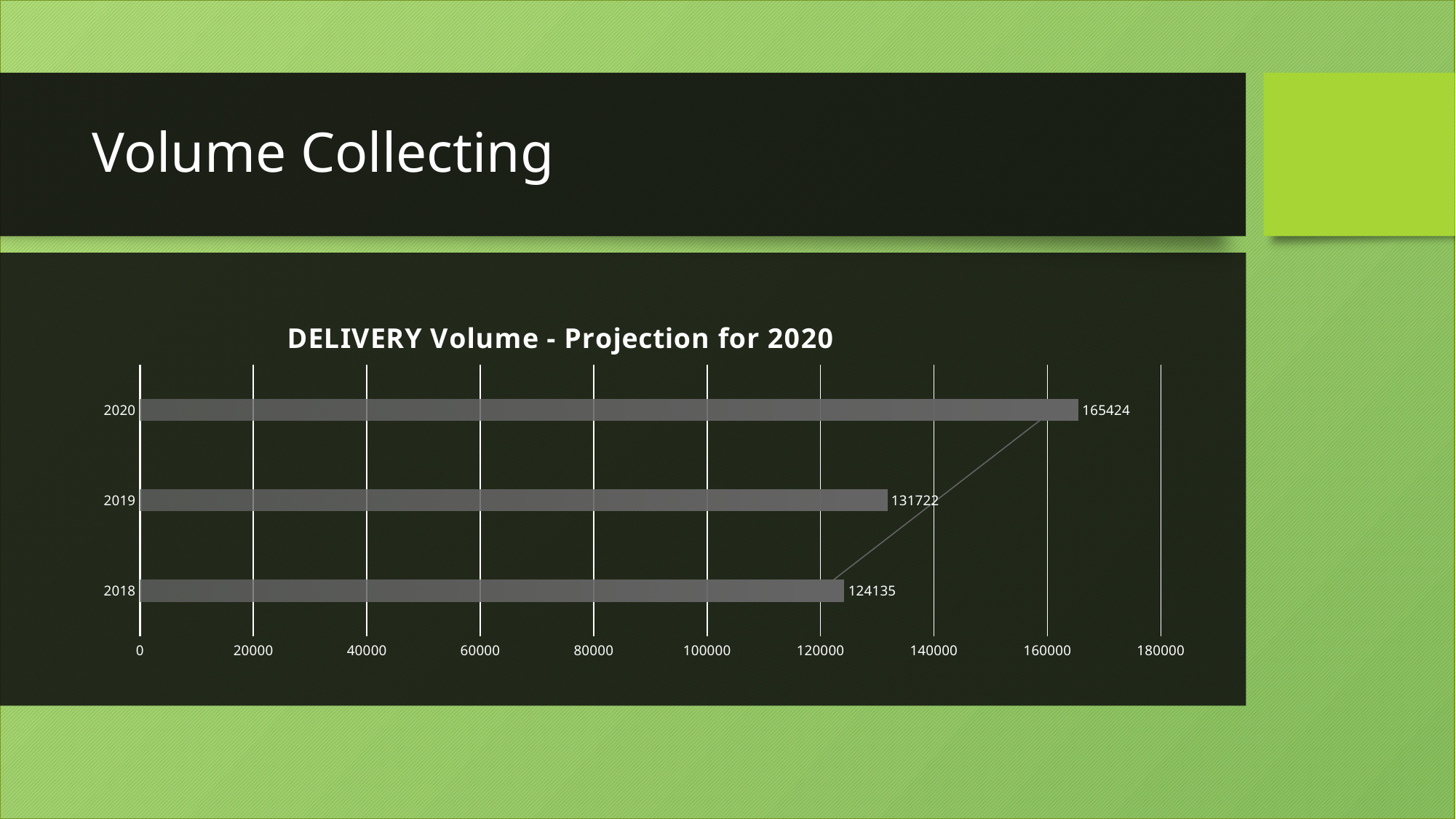
What is the difference between the 2020 and 2019 delivery volumes? 33702 What is the delivery volume value for 2018? 124135 What is the title of the chart? DELIVERY Volume - Projection for 2020 Which is larger, the delivery volume for 2019 or for 2018? 2019 Which year has the lowest delivery volume? 2018 What is the delivery volume value for 2019? 131722 What kind of chart is shown on the slide? bar chart Which year has the highest delivery volume? 2020 Is the value for 2020 greater or less than 160000? greater What is the difference between the 2019 and 2018 delivery volumes? 7587 How many years are shown in the chart? 3 What is the delivery volume value for 2020? 165424